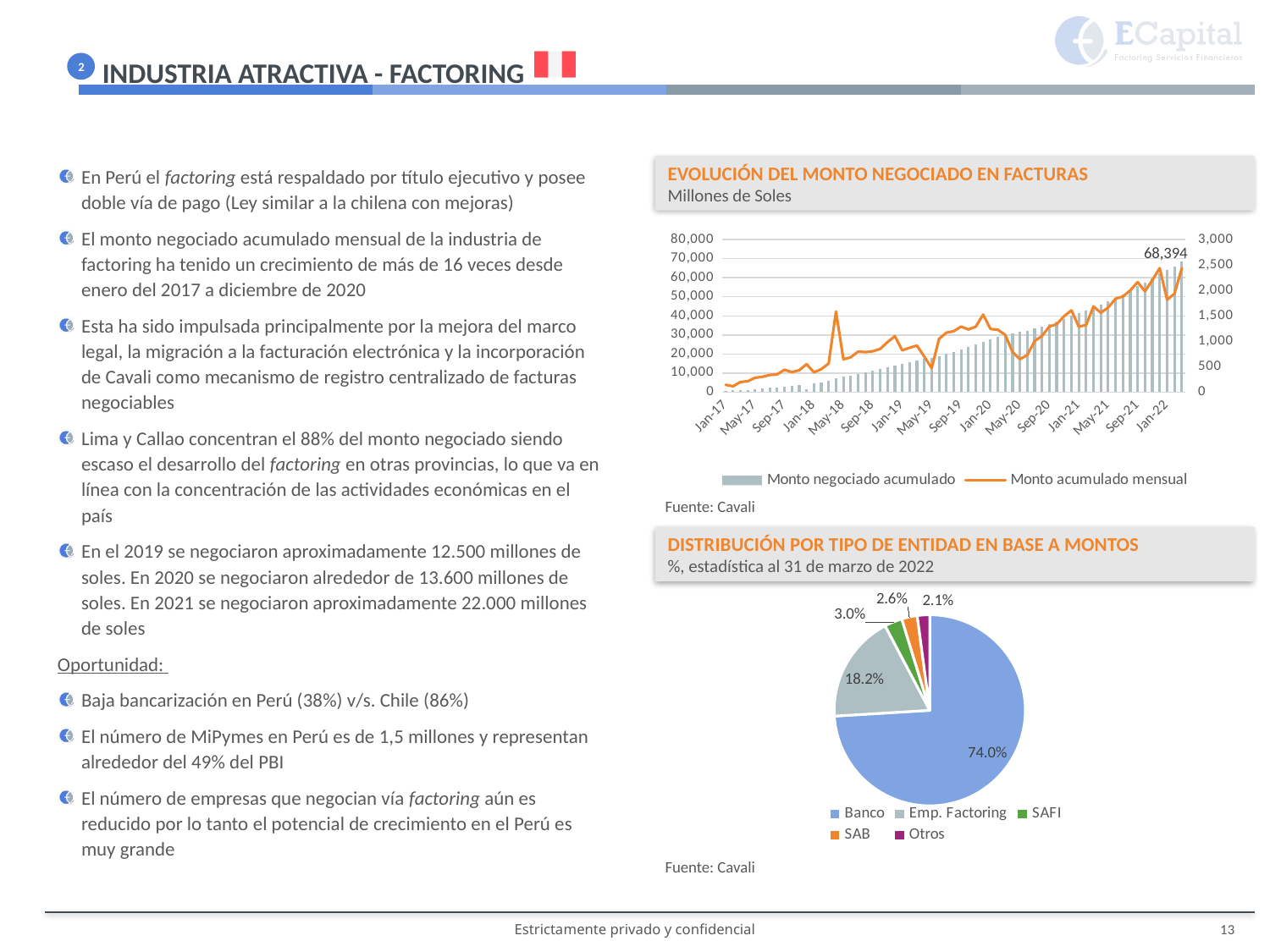
In the pie chart 'DISTRIBUCIÓN POR TIPO DE ENTIDAD EN BASE A MONTOS', which category has the smallest share? Otros In the pie chart 'DISTRIBUCIÓN POR TIPO DE ENTIDAD EN BASE A MONTOS', what share does Emp. Factoring have? 18.2% In the chart 'EVOLUCIÓN DEL MONTO NEGOCIADO EN FACTURAS', does the 'Monto negociado acumulado' series rise or fall from Jan-17 to Jan-22? rise In the chart 'EVOLUCIÓN DEL MONTO NEGOCIADO EN FACTURAS', what value is printed as the data label at the end of the series? 68,394 What kind of chart is 'DISTRIBUCIÓN POR TIPO DE ENTIDAD EN BASE A MONTOS'? pie chart How many series does the legend of the chart 'EVOLUCIÓN DEL MONTO NEGOCIADO EN FACTURAS' list? 2 In the pie chart 'DISTRIBUCIÓN POR TIPO DE ENTIDAD EN BASE A MONTOS', how many categories are shown? 5 What unit is stated in the subtitle of the chart 'EVOLUCIÓN DEL MONTO NEGOCIADO EN FACTURAS'? Millones de Soles In the chart 'EVOLUCIÓN DEL MONTO NEGOCIADO EN FACTURAS', is the last bar of 'Monto negociado acumulado' greater or less than 60,000? greater In the pie chart 'DISTRIBUCIÓN POR TIPO DE ENTIDAD EN BASE A MONTOS', what is the difference in percentage points between Banco and Emp. Factoring? 55.8 In the chart 'EVOLUCIÓN DEL MONTO NEGOCIADO EN FACTURAS', which series is drawn as a line? Monto acumulado mensual In the pie chart 'DISTRIBUCIÓN POR TIPO DE ENTIDAD EN BASE A MONTOS', what share does Banco have? 74.0%